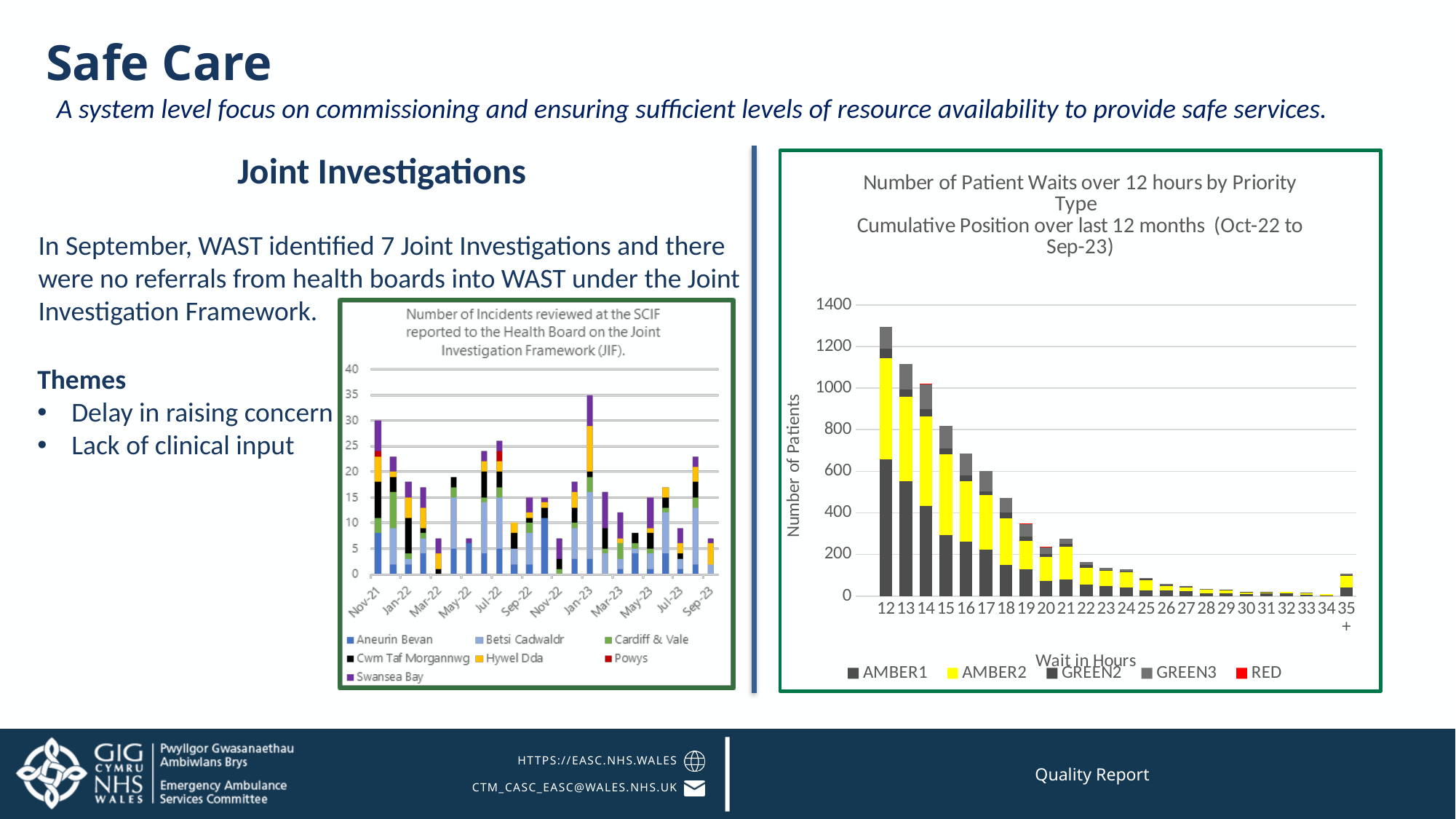
In the 'Number of Incidents reviewed at the SCIF' chart, is the total for Mar-22 greater or less than 10? less In the 'Number of Patient Waits over 12 hours by Priority Type' chart, is the total for 12 hours greater or less than 1200? greater In the 'Number of Patient Waits over 12 hours by Priority Type' chart, do the totals generally rise or fall as wait in hours increases from 12 to 34? fall How many series does the legend of the 'Number of Patient Waits over 12 hours by Priority Type' chart list? 5 In the 'Number of Incidents reviewed at the SCIF' chart, is the total for Jan-23 greater or less than 30? greater How many series does the legend of the 'Number of Incidents reviewed at the SCIF' chart on the left list? 7 What is the x-axis label of the 'Number of Patient Waits over 12 hours by Priority Type' chart? Wait in Hours What kind of chart is the 'Number of Patient Waits over 12 hours by Priority Type' chart on the right? Stacked bar chart In the 'Number of Patient Waits over 12 hours by Priority Type' chart, which wait-in-hours category has the highest total number of patients? 12 In the 'Number of Incidents reviewed at the SCIF' chart, which month has the highest total number of incidents? Jan-23